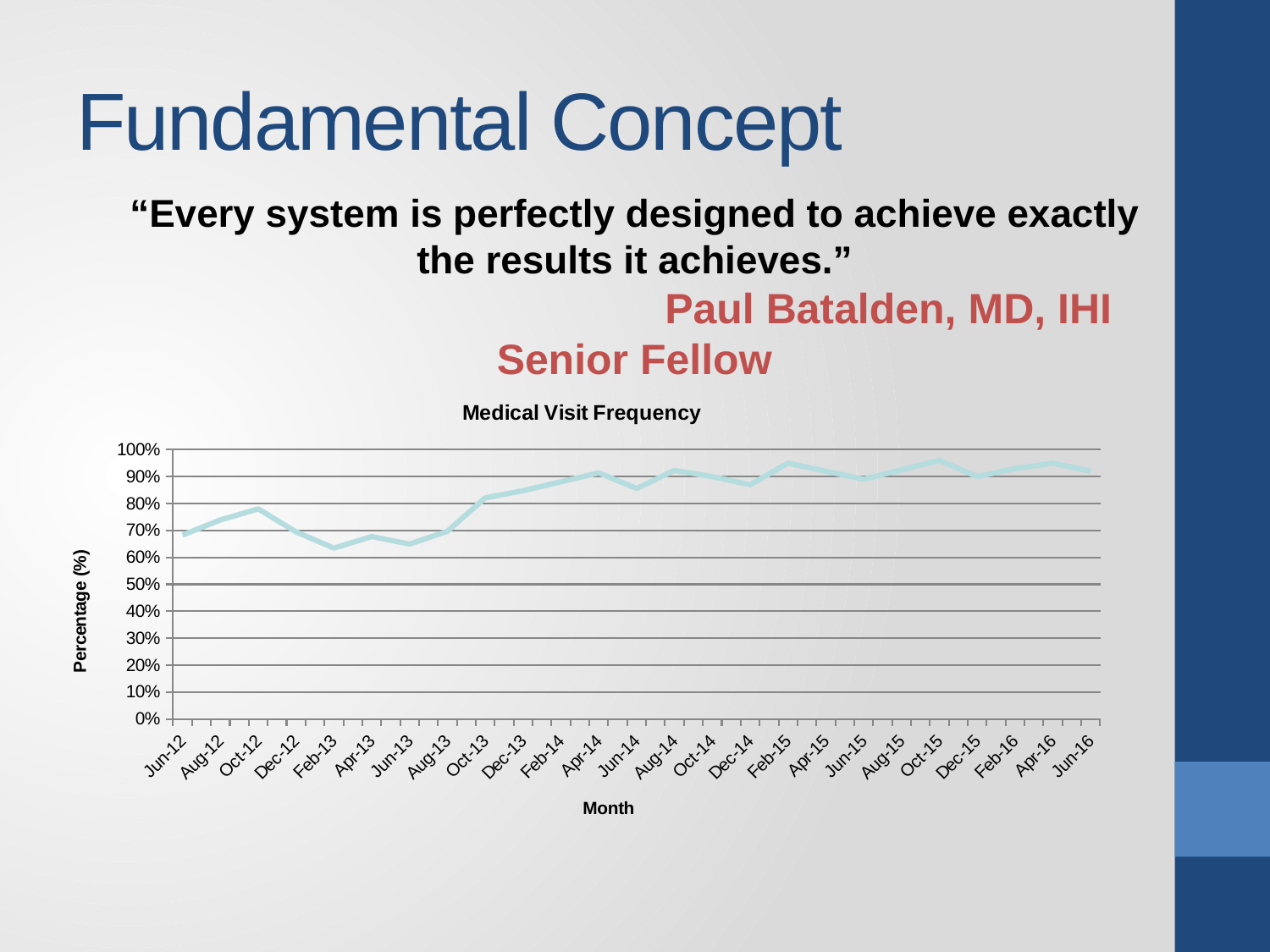
Is the value for Oct-15 greater or less than 90%? greater What is the label of the vertical axis of the chart? Percentage (%) Overall, do the values rise or fall from Jun-12 to Jun-16? rise Is the value for Feb-15 greater or less than 90%? greater Is the value for Oct-12 greater or less than 80%? less What is the title of the chart? Medical Visit Frequency What kind of chart is shown on the slide? line chart